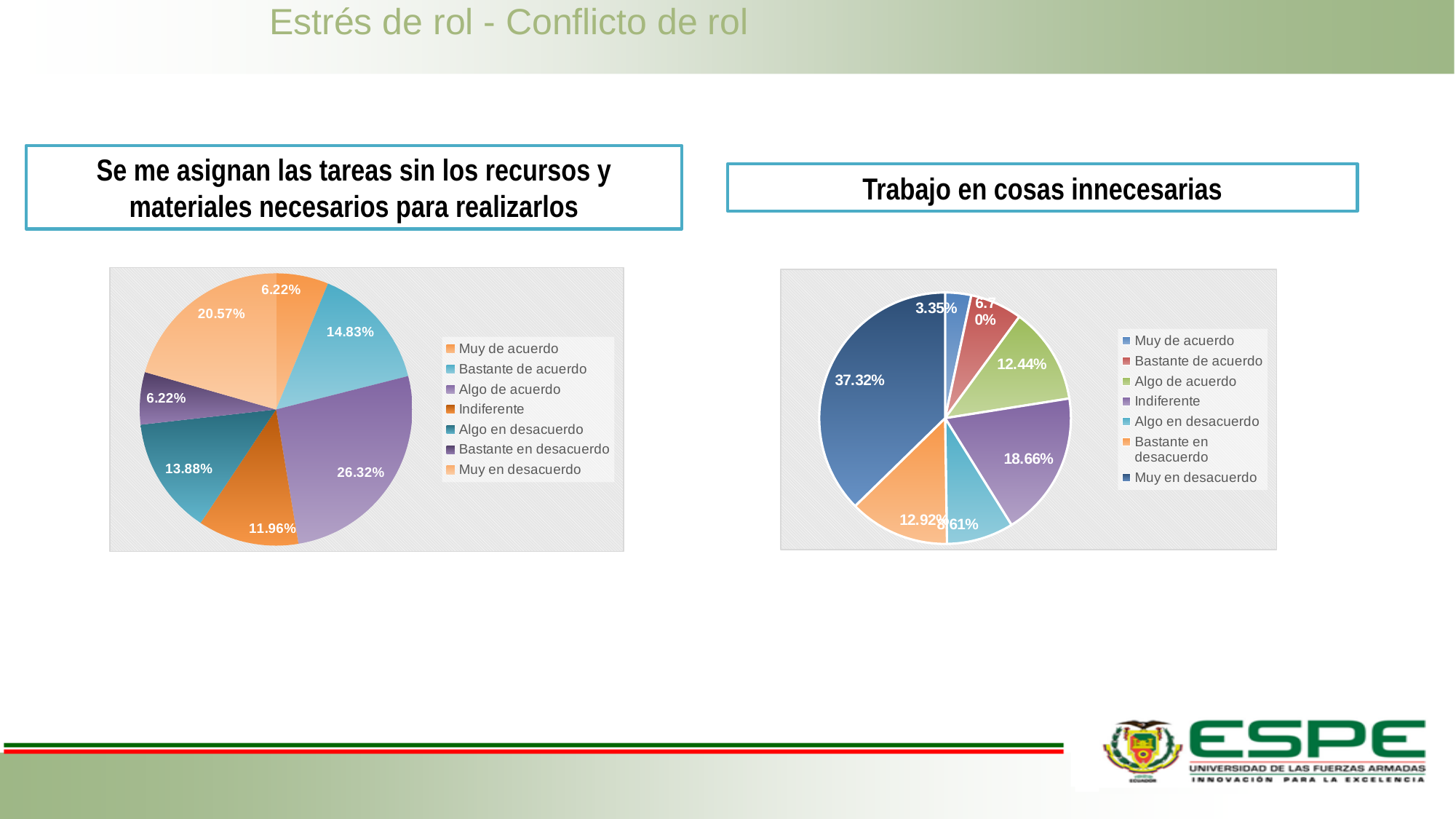
In the right pie chart (Trabajo en cosas innecesarias), which category has the smallest share? Muy de acuerdo In the right pie chart (Trabajo en cosas innecesarias), what percentage corresponds to Indiferente? 18.66% How many categories does the legend of the left pie chart (Se me asignan las tareas sin los recursos y materiales necesarios para realizarlos) list? 7 In the right pie chart (Trabajo en cosas innecesarias), what is the difference between the Muy en desacuerdo and Indiferente shares? 18.66% In the left pie chart (Se me asignan las tareas sin los recursos y materiales necesarios para realizarlos), what percentage corresponds to Muy en desacuerdo? 20.57% In the left pie chart (Se me asignan las tareas sin los recursos y materiales necesarios para realizarlos), which is larger: Bastante de acuerdo or Algo en desacuerdo? Bastante de acuerdo In the left pie chart (Se me asignan las tareas sin los recursos y materiales necesarios para realizarlos), which category has the largest share? Algo de acuerdo In the right pie chart (Trabajo en cosas innecesarias), what percentage corresponds to Muy en desacuerdo? 37.32% In the left pie chart (Se me asignan las tareas sin los recursos y materiales necesarios para realizarlos), what is the difference between the Algo de acuerdo and Indiferente shares? 14.36% In the right pie chart (Trabajo en cosas innecesarias), which is larger: Algo de acuerdo or Bastante en desacuerdo? Bastante en desacuerdo What type of chart is used for Trabajo en cosas innecesarias? Pie chart In the left pie chart (Se me asignan las tareas sin los recursos y materiales necesarios para realizarlos), what percentage corresponds to Algo de acuerdo? 26.32%